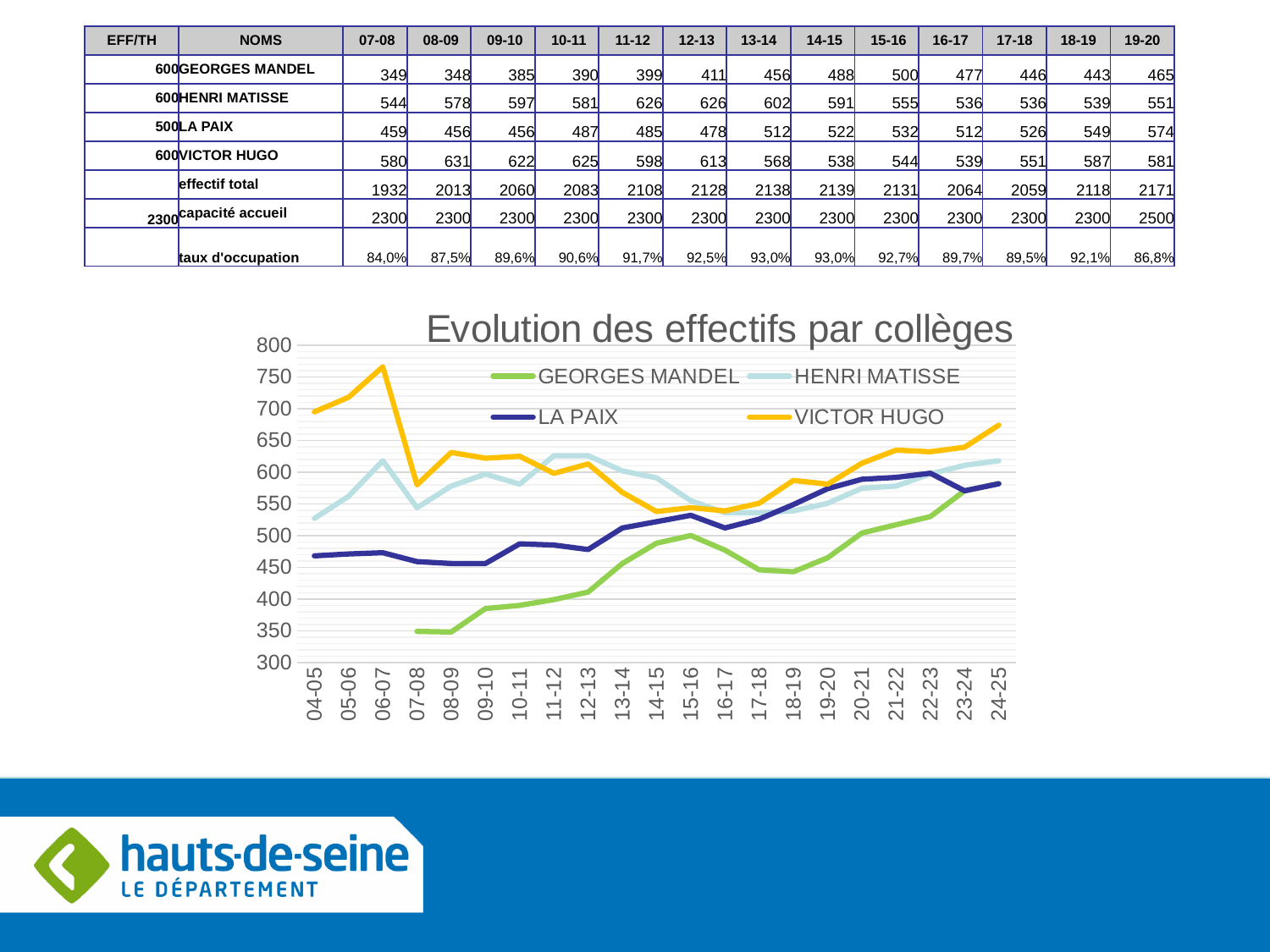
Which series has the lowest value in 15-16? GEORGES MANDEL How many series does the chart legend list? 4 Which series has the highest value in 06-07? VICTOR HUGO What colour is the GEORGES MANDEL line in the chart? green In 13-14, which is larger: LA PAIX or GEORGES MANDEL? LA PAIX What is the title of the chart? Evolution des effectifs par collèges Is the value for HENRI MATISSE in 24-25 greater or less than 600? greater What kind of chart is shown on the slide? line chart Is the value for VICTOR HUGO in 06-07 greater or less than 750? greater How many school-year points are shown on the x axis of the chart? 21 Is the value for LA PAIX in 04-05 greater or less than 500? less Does the GEORGES MANDEL line rise or fall from 07-08 to 15-16? rise